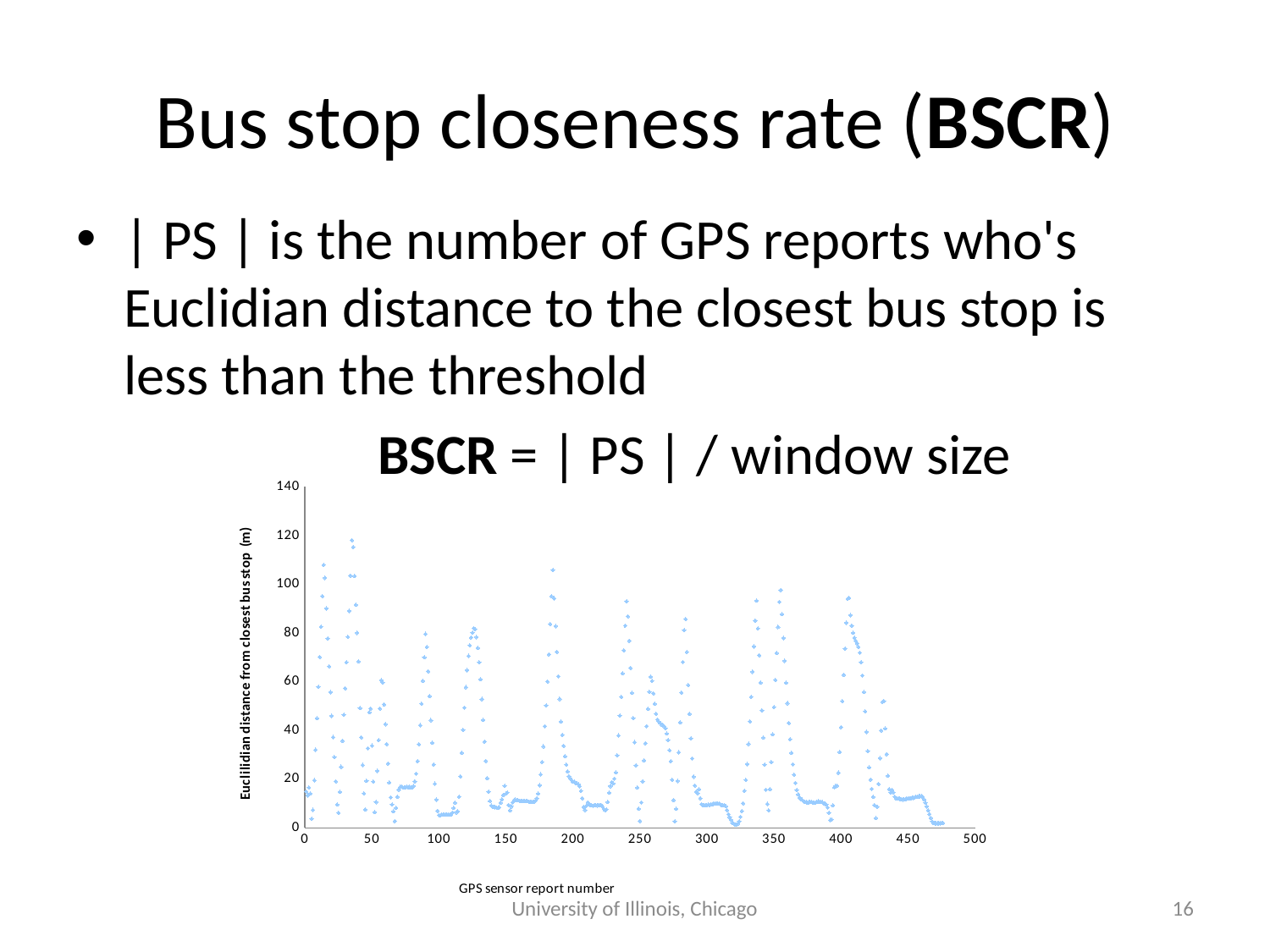
What is the title of the vertical axis of the chart? Euclilidian distance from closest bus stop (m) What is the title of the horizontal axis of the chart? GPS sensor report number Is the highest plotted distance in the chart greater or less than 100? greater Are the plotted distances around GPS sensor report number 320 greater or less than 20? less Is the lowest plotted distance in the chart greater or less than 20? less What kind of chart is shown on the slide? scatter chart